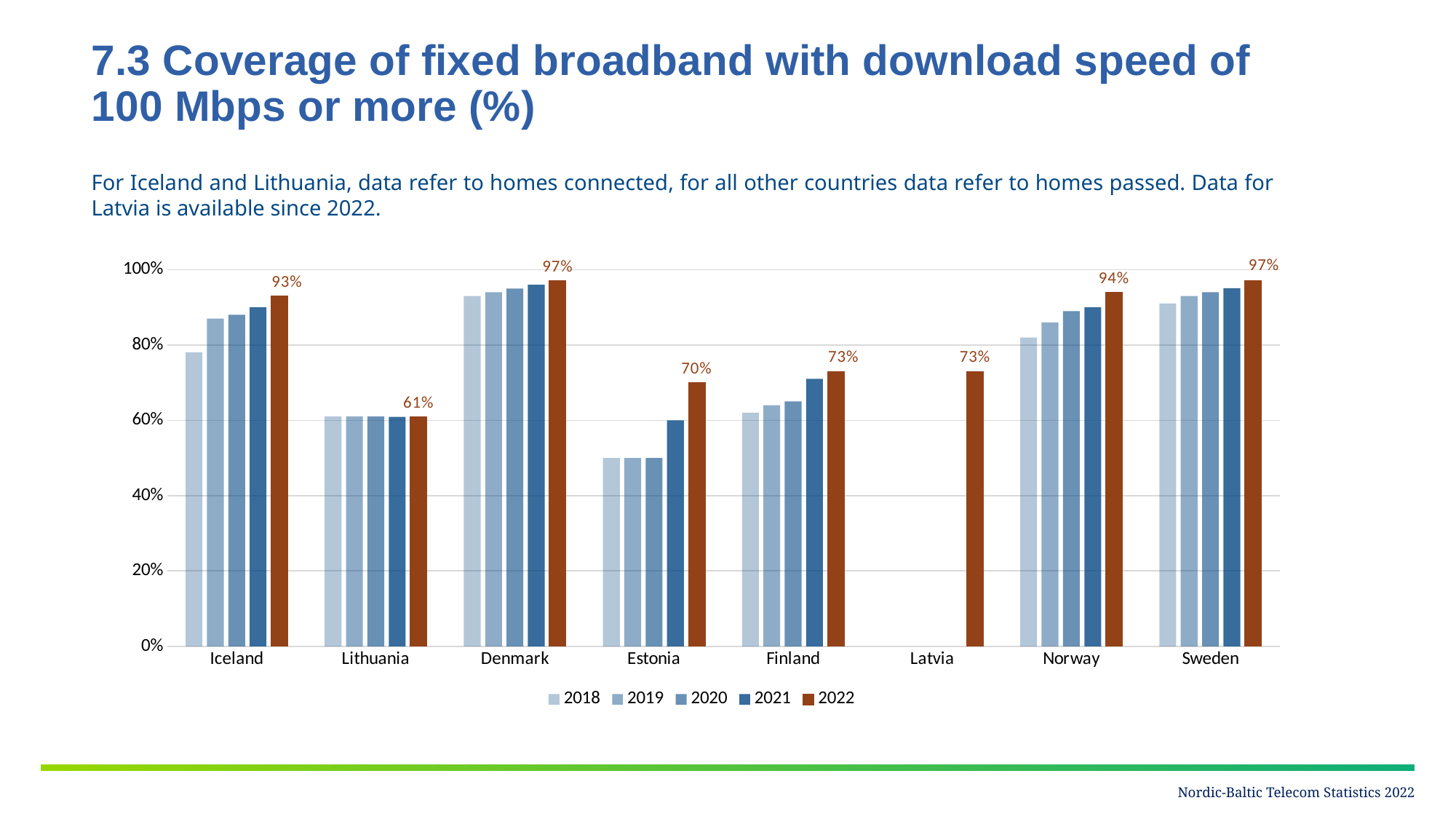
How many countries are shown on the x axis? 8 Which country has the lowest value in 2022? Lithuania What is the difference between the 2022 values for Iceland and Estonia? 23 percentage points Which is larger, the 2022 value for Norway or the 2022 value for Finland? Norway Is the value for Estonia in 2018 greater or less than 60%? less What is the value for Latvia in 2022? 73% Is the value for Denmark in 2018 greater or less than 80%? greater What is the value for Iceland in 2022? 93% What is the value for Norway in 2022? 94% How many series does the legend list? 5 What kind of chart is shown on the slide? Bar chart What is the value for Estonia in 2022? 70%